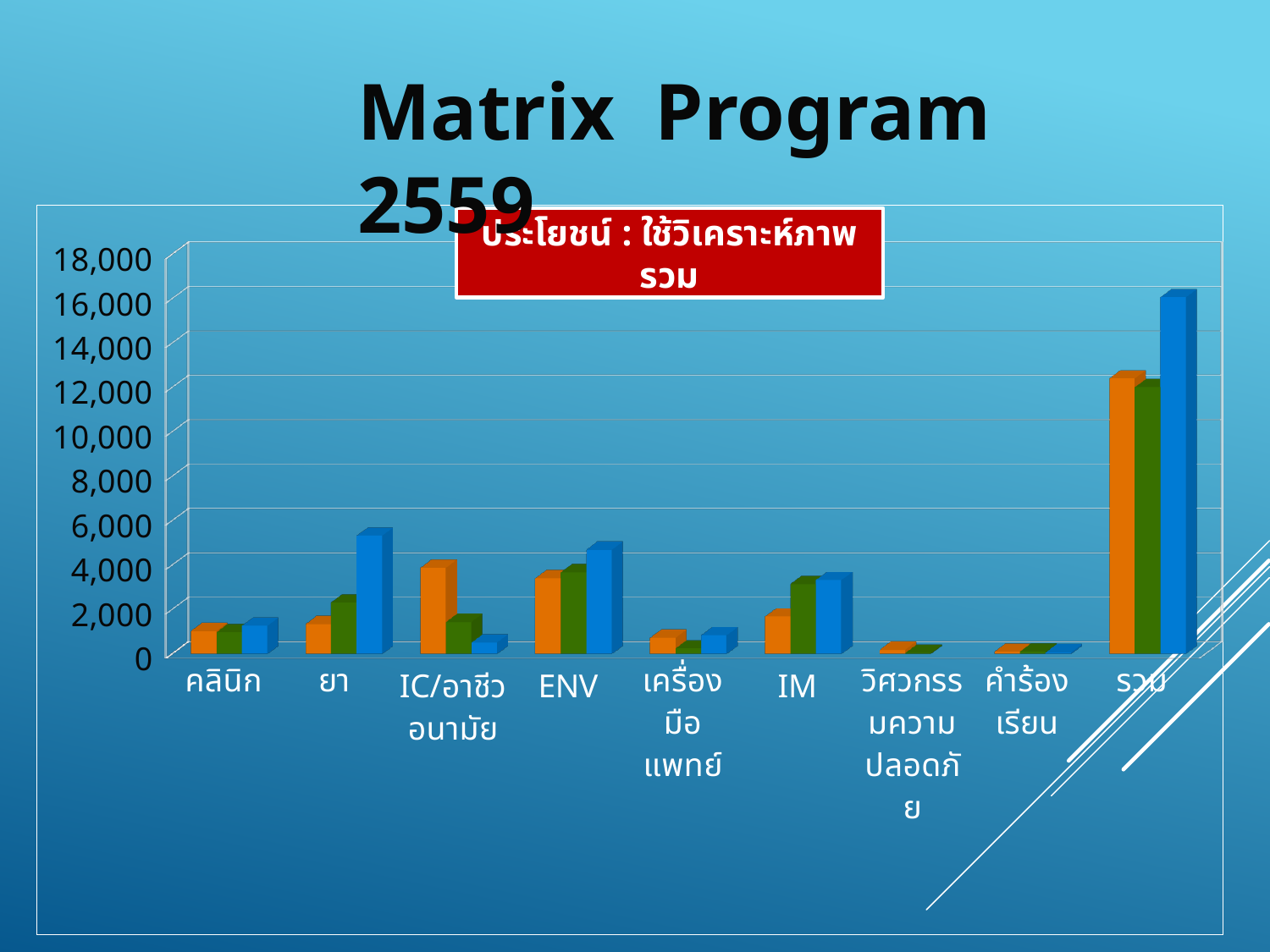
Is the value of the blue bar for คลินิก greater or less than 2,000? less Is the value of the blue bar for รวม greater or less than 14,000? greater How many categories are shown on the x axis of the chart? 9 For the category IC/อาชีวอนามัย, which bar is larger, the orange bar or the blue bar? orange bar Which category has the tallest bar in the chart? รวม What kind of chart is shown on the slide? bar chart How many bars are shown for each category in the chart? 3 Is the value of the orange bar for IC/อาชีวอนามัย greater or less than 2,000? greater What is the title of the slide containing the chart? Matrix Program 2559 For the category ยา, which bar is larger, the blue bar or the orange bar? blue bar